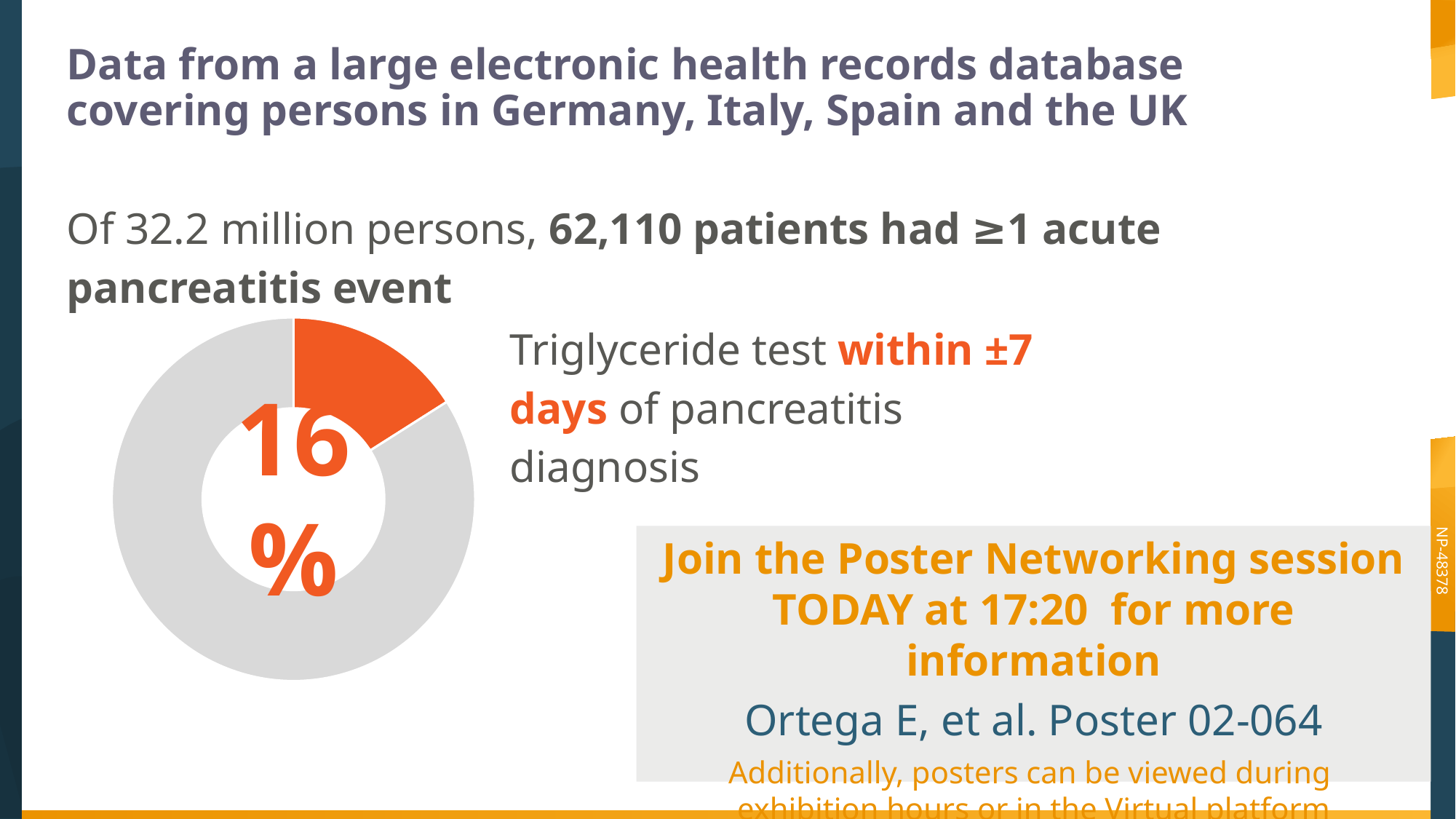
What share of the doughnut chart is not highlighted in orange? 84% What kind of chart is shown on the slide? doughnut chart What colour is the highlighted segment of the doughnut chart? orange Is the value shown in the doughnut chart greater or less than 50%? less How many segments does the doughnut chart have? 2 Which segment of the doughnut chart is larger, the orange one or the grey one? the grey one What percentage does the highlighted (orange) segment of the doughnut chart represent? 16% What does the highlighted segment of the doughnut chart represent? Triglyceride test within ±7 days of pancreatitis diagnosis What share of patients had a triglyceride test within ±7 days of pancreatitis diagnosis, according to the chart? 16%